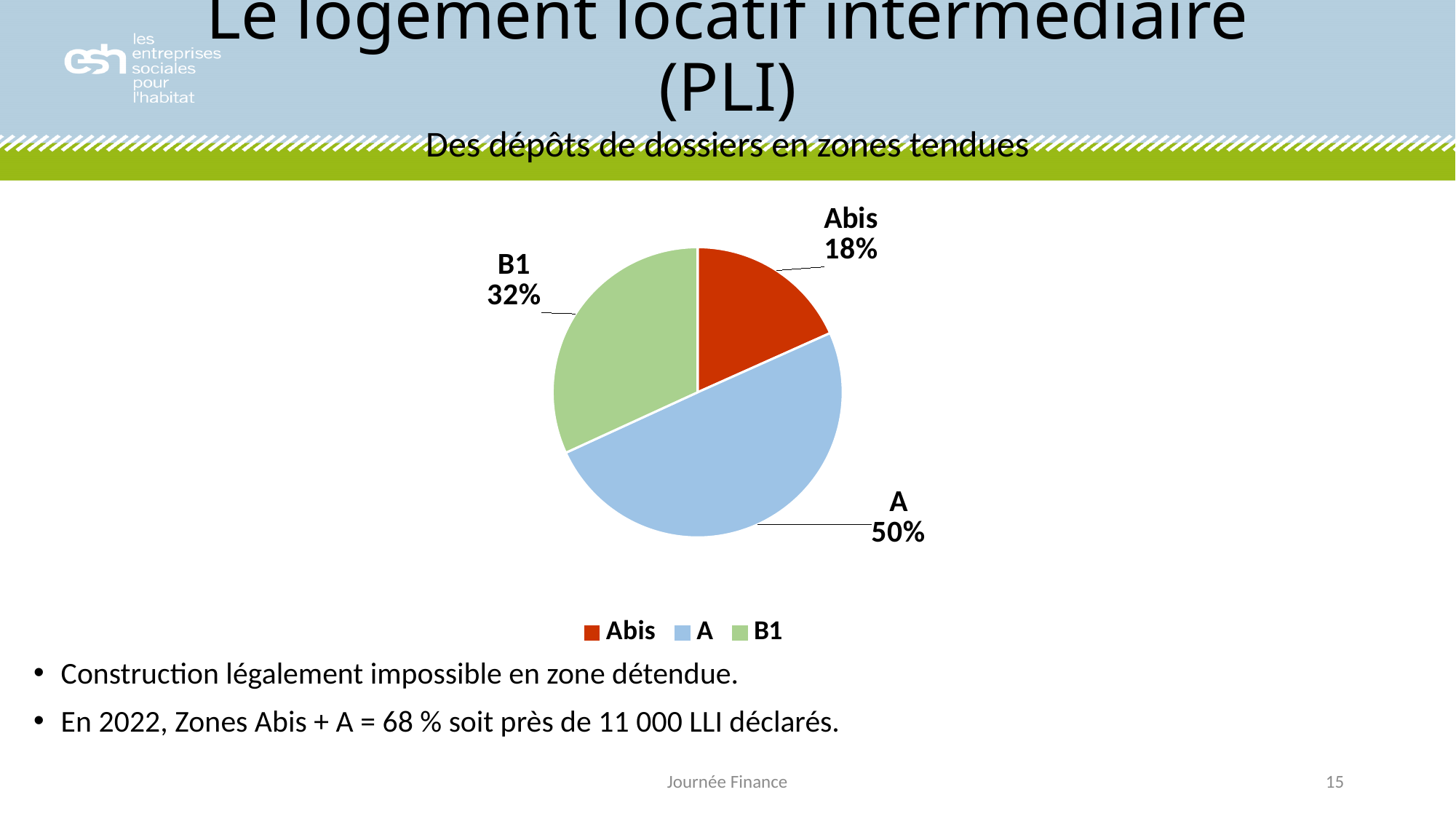
What share of the pie does zone A represent? 50% What are the three entries listed in the legend? Abis, A, B1 What share of the pie does zone B1 represent? 32% What share of the pie does zone Abis represent? 18% How many slices does the pie chart have? 3 What is the difference in percentage points between the shares of zone A and zone B1? 18 What colour is the slice for zone Abis? Red Which zone has the smallest share of the pie? Abis Which zone has the largest share of the pie? A Which has the larger share, zone B1 or zone Abis? B1 What kind of chart is shown on the slide? Pie chart What is the difference in percentage points between the shares of zone B1 and zone Abis? 14